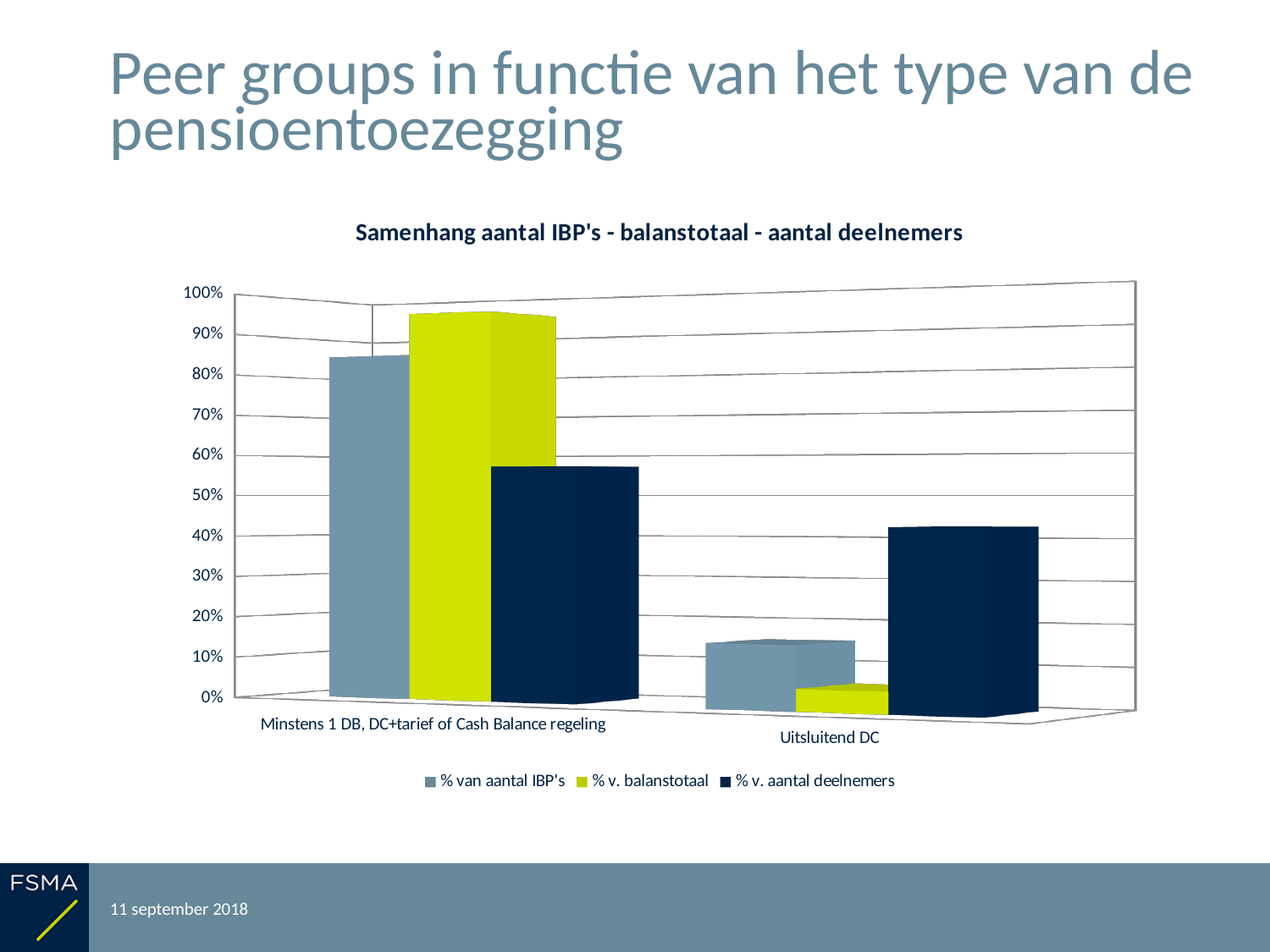
For 'Minstens 1 DB, DC+tarief of Cash Balance regeling', which is larger: % v. balanstotaal or % v. aantal deelnemers? % v. balanstotaal Is the value of % van aantal IBP's for 'Minstens 1 DB, DC+tarief of Cash Balance regeling' greater or less than 80%? greater Which series is shown in yellow-green? % v. balanstotaal Is the value of % van aantal IBP's for 'Uitsluitend DC' greater or less than 20%? less Which series has the highest value for 'Uitsluitend DC'? % v. aantal deelnemers What is the title of the chart? Samenhang aantal IBP's - balanstotaal - aantal deelnemers Is the value of % v. aantal deelnemers for 'Uitsluitend DC' greater or less than 30%? greater How many categories are shown on the x axis? 2 What kind of chart is shown on the slide? bar chart How many series does the legend list? 3